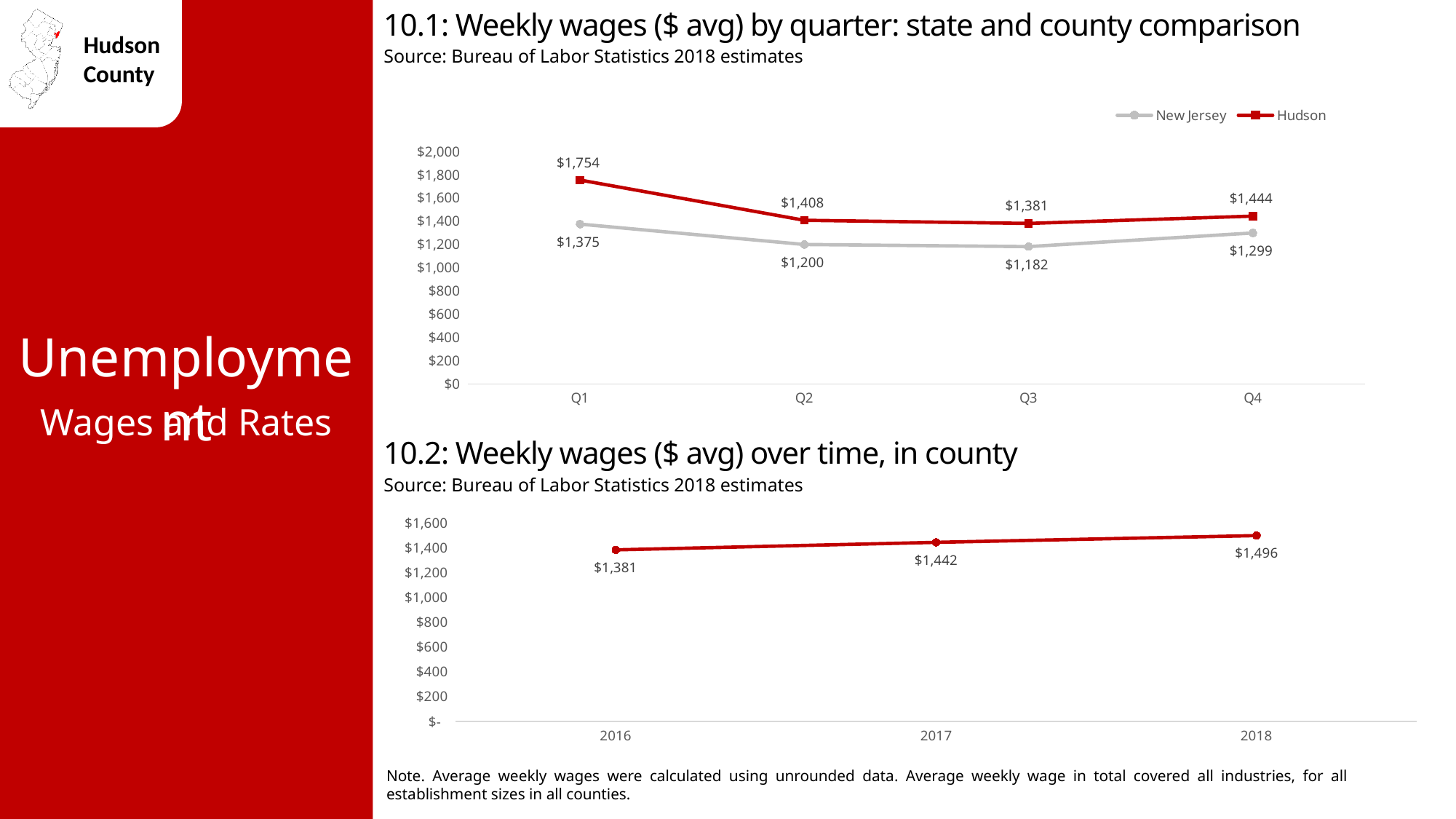
In chart 10.1 (Weekly wages by quarter: state and county comparison), which quarter has the lowest New Jersey value? Q3 In chart 10.2 (Weekly wages over time, in county), do the values rise or fall from 2016 to 2018? rise In chart 10.1 (Weekly wages by quarter: state and county comparison), how many quarters are plotted on the x axis? 4 What kind of chart is chart 10.2 (Weekly wages over time, in county)? line chart In chart 10.1 (Weekly wages by quarter: state and county comparison), which is larger in Q4: Hudson or New Jersey? Hudson In chart 10.1 (Weekly wages by quarter: state and county comparison), what is the Hudson value for Q1? $1,754 In chart 10.1 (Weekly wages by quarter: state and county comparison), what is the difference between the Hudson and New Jersey values in Q1? $379 In chart 10.2 (Weekly wages over time, in county), what is the value for 2017? $1,442 In chart 10.1 (Weekly wages by quarter: state and county comparison), which quarter has the highest Hudson value? Q1 In chart 10.1 (Weekly wages by quarter: state and county comparison), what is the New Jersey value for Q3? $1,182 In chart 10.1 (Weekly wages by quarter: state and county comparison), how many series does the legend list? 2 In chart 10.2 (Weekly wages over time, in county), what is the difference between the 2018 and 2016 values? $115